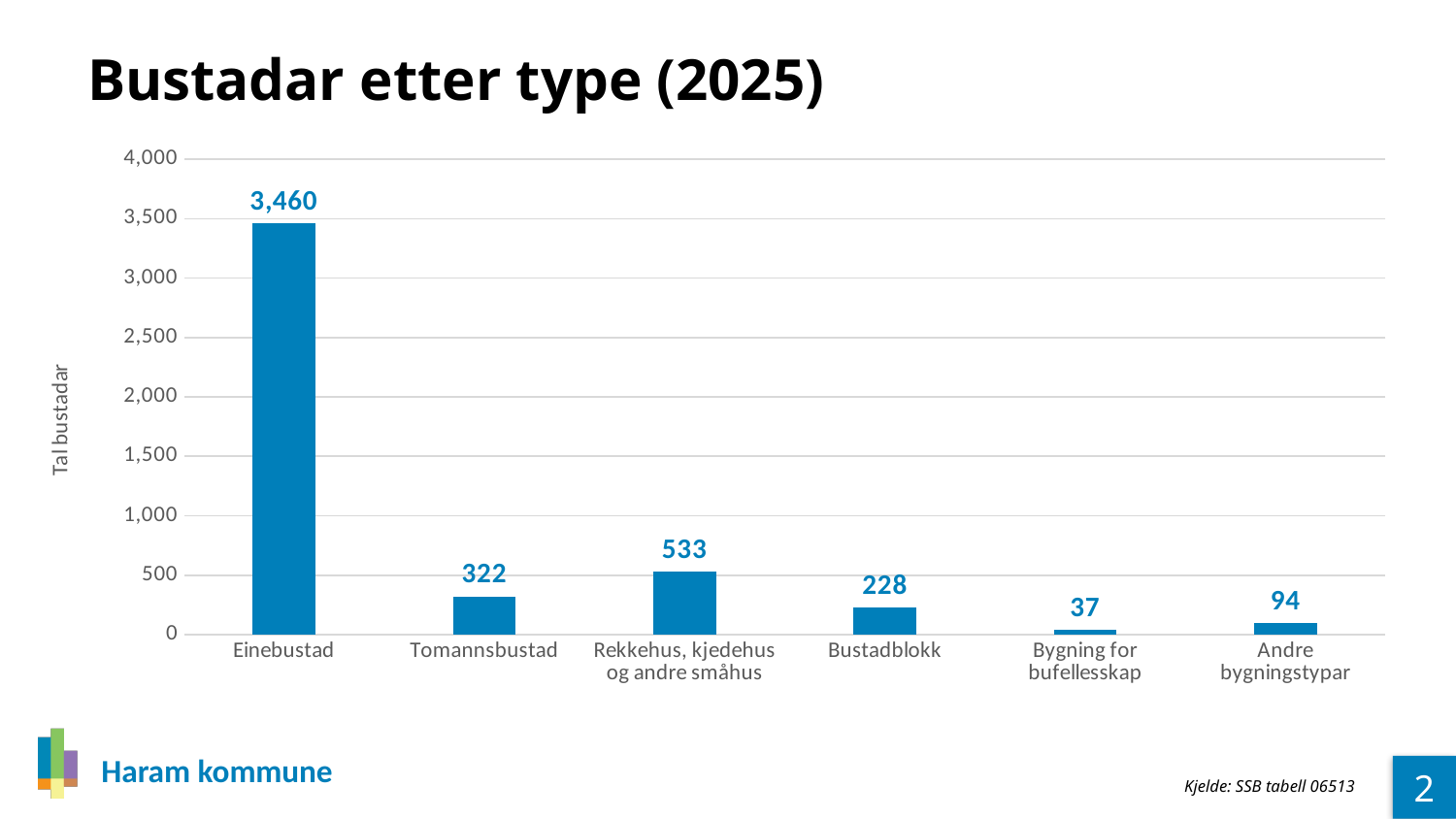
What is the title of the chart? Bustadar etter type (2025) What is the value for Bygning for bufellesskap? 37 What kind of chart is shown on the slide? bar chart Is the value for Tomannsbustad greater or less than 500? less What is the label of the y axis? Tal bustadar What is the difference between the values for Rekkehus, kjedehus og andre småhus and Tomannsbustad? 211 What is the value for Rekkehus, kjedehus og andre småhus? 533 Which category has the highest value? Einebustad What is the value for Einebustad? 3,460 Which category has the lowest value? Bygning for bufellesskap How many categories are shown on the x axis? 6 Which is larger, the value for Bustadblokk or the value for Andre bygningstypar? Bustadblokk